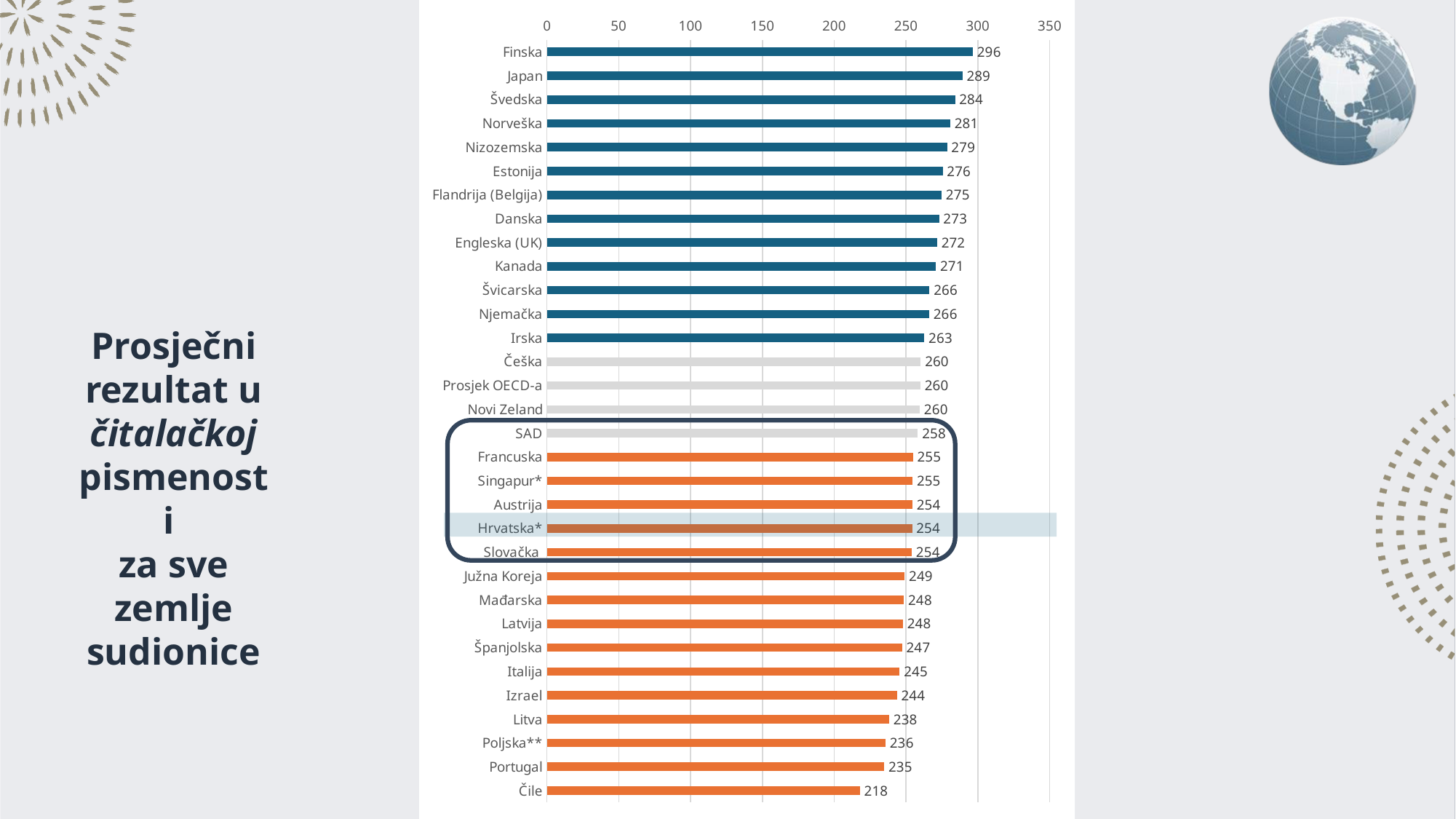
How many categories are shown in the chart? 32 Which category has the lowest value? Čile What colour are the bars for Francuska, Austrija and Slovačka? orange What is the difference between the values for Finska and Čile? 78 Which category has the highest value? Finska What is the value for Finska? 296 Is the value for Portugal greater or less than 250? less What is the value for Hrvatska*? 254 What is the difference between the values for Japan and Hrvatska*? 35 Which is larger, the value for Estonija or the value for Irska? Estonija What is the value for Prosjek OECD-a? 260 What kind of chart is shown on the slide? bar chart